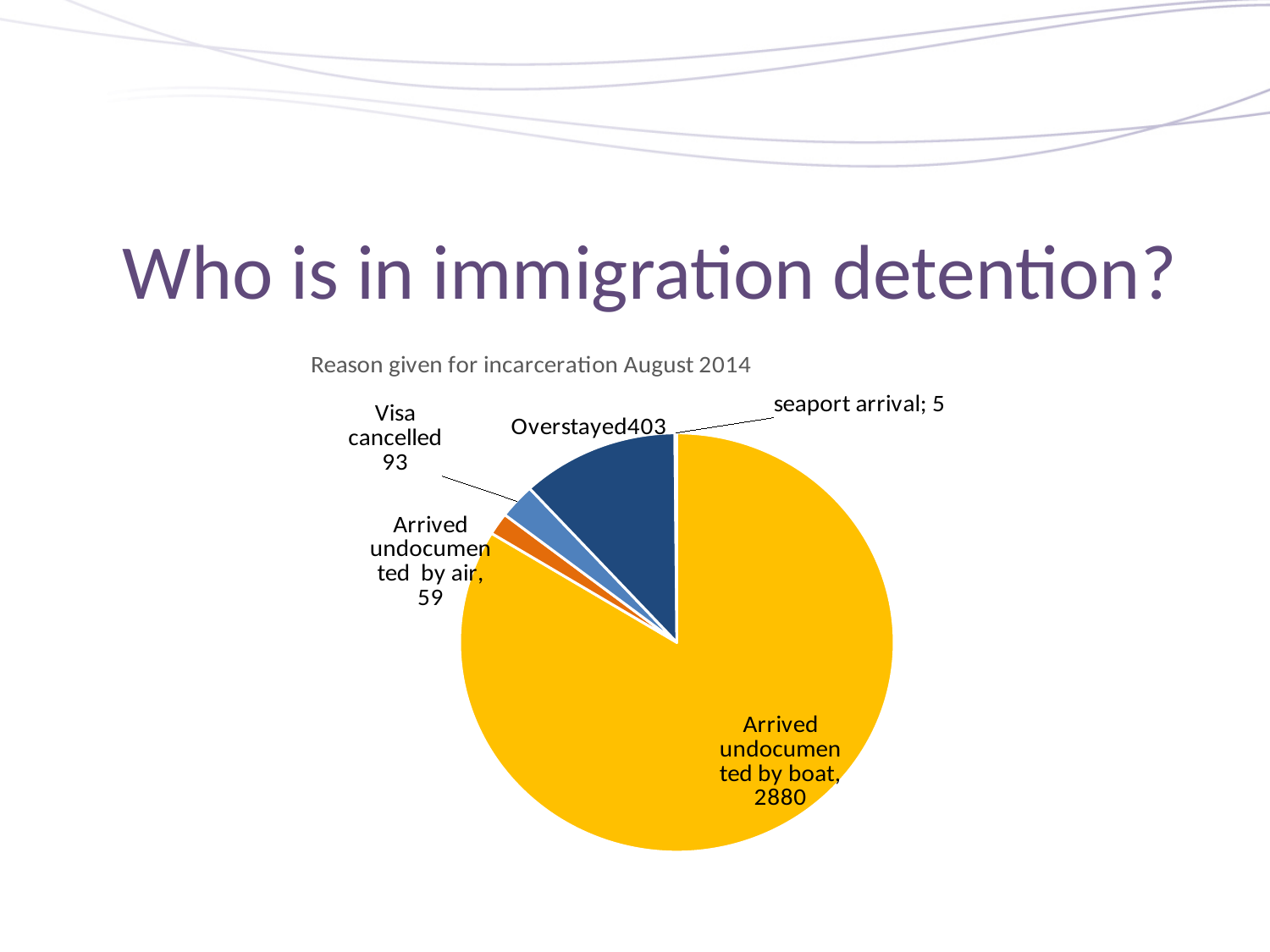
What is the value for Arrived undocumented by air? 59 What kind of chart is shown on the slide? Pie chart Which category has the smallest slice of the pie? seaport arrival What is the value for Overstayed? 403 Which is larger, Visa cancelled or Arrived undocumented by air? Visa cancelled What is the value for Arrived undocumented by boat? 2880 What is the difference between the values for Arrived undocumented by boat and Overstayed? 2477 Which category has the largest slice of the pie? Arrived undocumented by boat What is the value for Visa cancelled? 93 What is the title of the chart? Reason given for incarceration August 2014 What is the value for seaport arrival? 5 How many categories are shown in the pie chart? 5